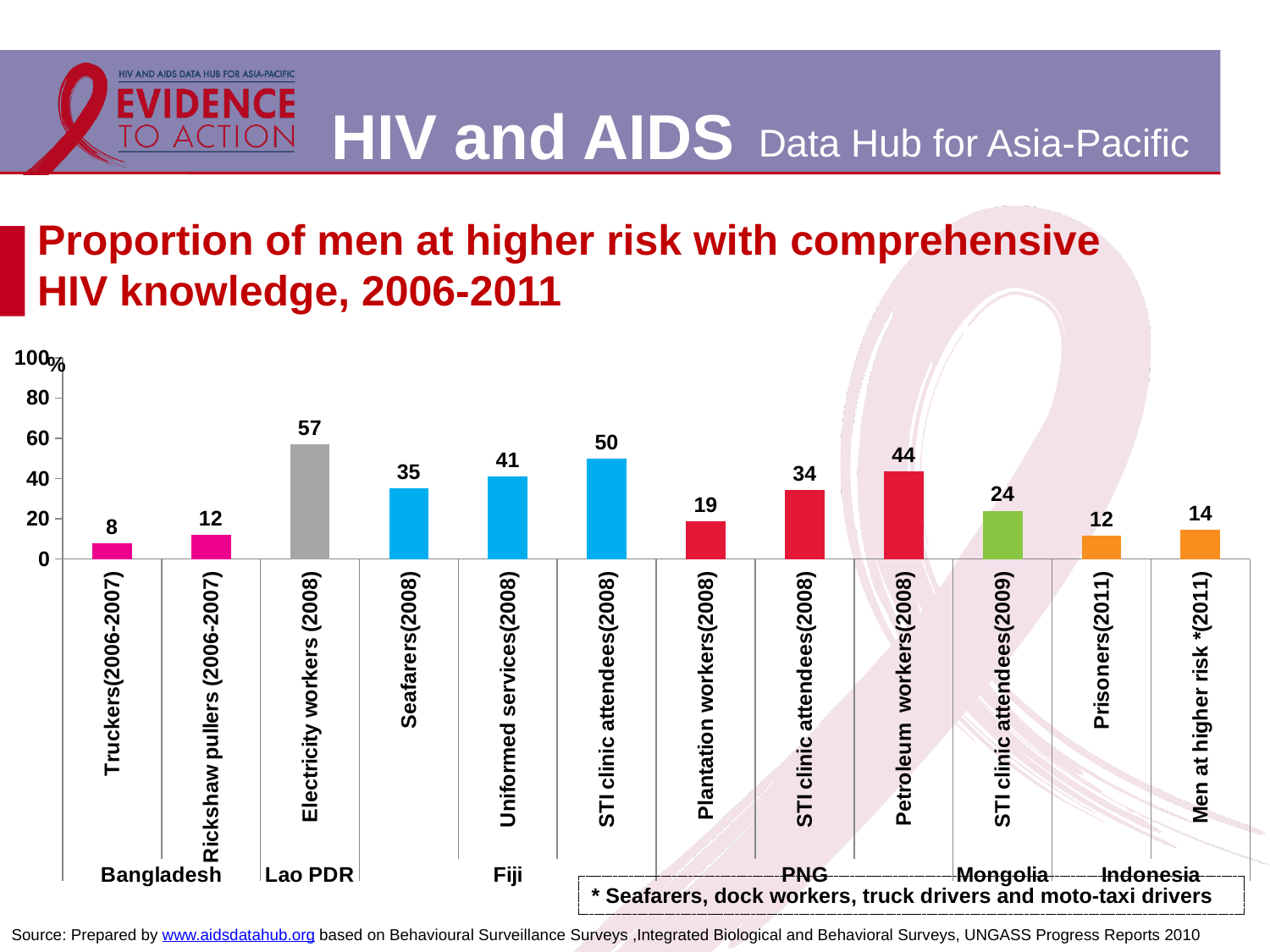
What is the value for Electricity workers (2008) in Lao PDR? 57 Which category has the lowest value? Truckers (2006-2007), Bangladesh What is the difference between the values for Uniformed services (2008) in Fiji and Seafarers (2008) in Fiji? 6 How many bars are plotted in the chart? 12 Is the value for Plantation workers (2008) in PNG greater or less than 20? less What is the value for STI clinic attendees (2008) in Fiji? 50 What is the value for Petroleum workers (2008) in PNG? 44 Which category has the highest value? Electricity workers (2008), Lao PDR Which is larger: the value for STI clinic attendees (2008) in PNG or the value for STI clinic attendees (2009) in Mongolia? STI clinic attendees (2008) in PNG What is the value for Truckers (2006-2007) in Bangladesh? 8 What type of chart is shown on the slide? bar chart What is the title of the chart? Proportion of men at higher risk with comprehensive HIV knowledge, 2006-2011